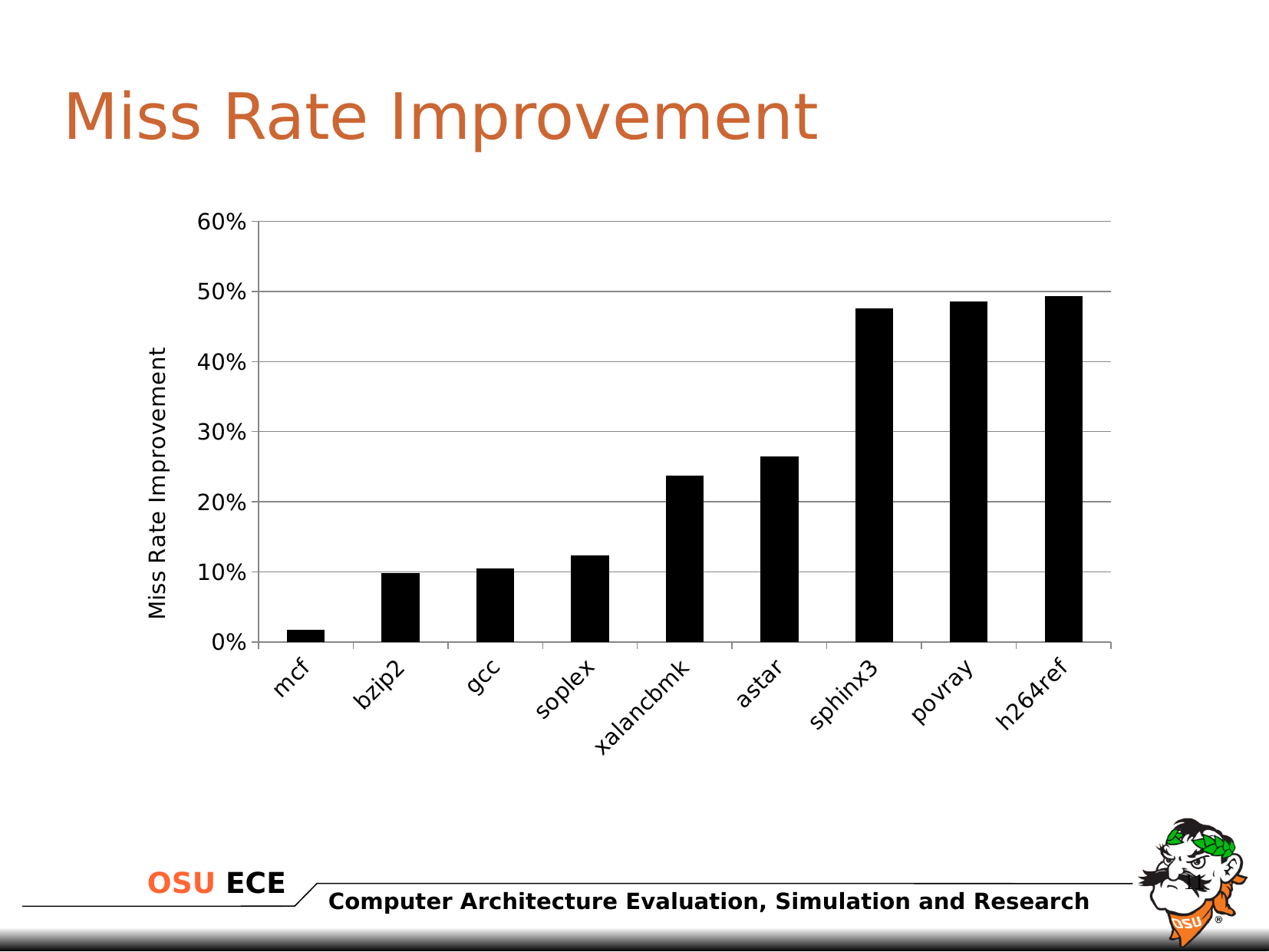
Is the miss rate improvement for astar greater or less than 30%? less Is the miss rate improvement for xalancbmk greater or less than 20%? greater Which has a larger miss rate improvement, astar or xalancbmk? astar Is the miss rate improvement for sphinx3 greater or less than 40%? greater Which benchmark has the lowest miss rate improvement? mcf Which has a larger miss rate improvement, gcc or sphinx3? sphinx3 How many benchmarks are plotted on the x axis? 9 What is the label on the vertical axis? Miss Rate Improvement Do the bars rise or fall from left to right along the x axis? rise What kind of chart is shown on the slide? bar chart